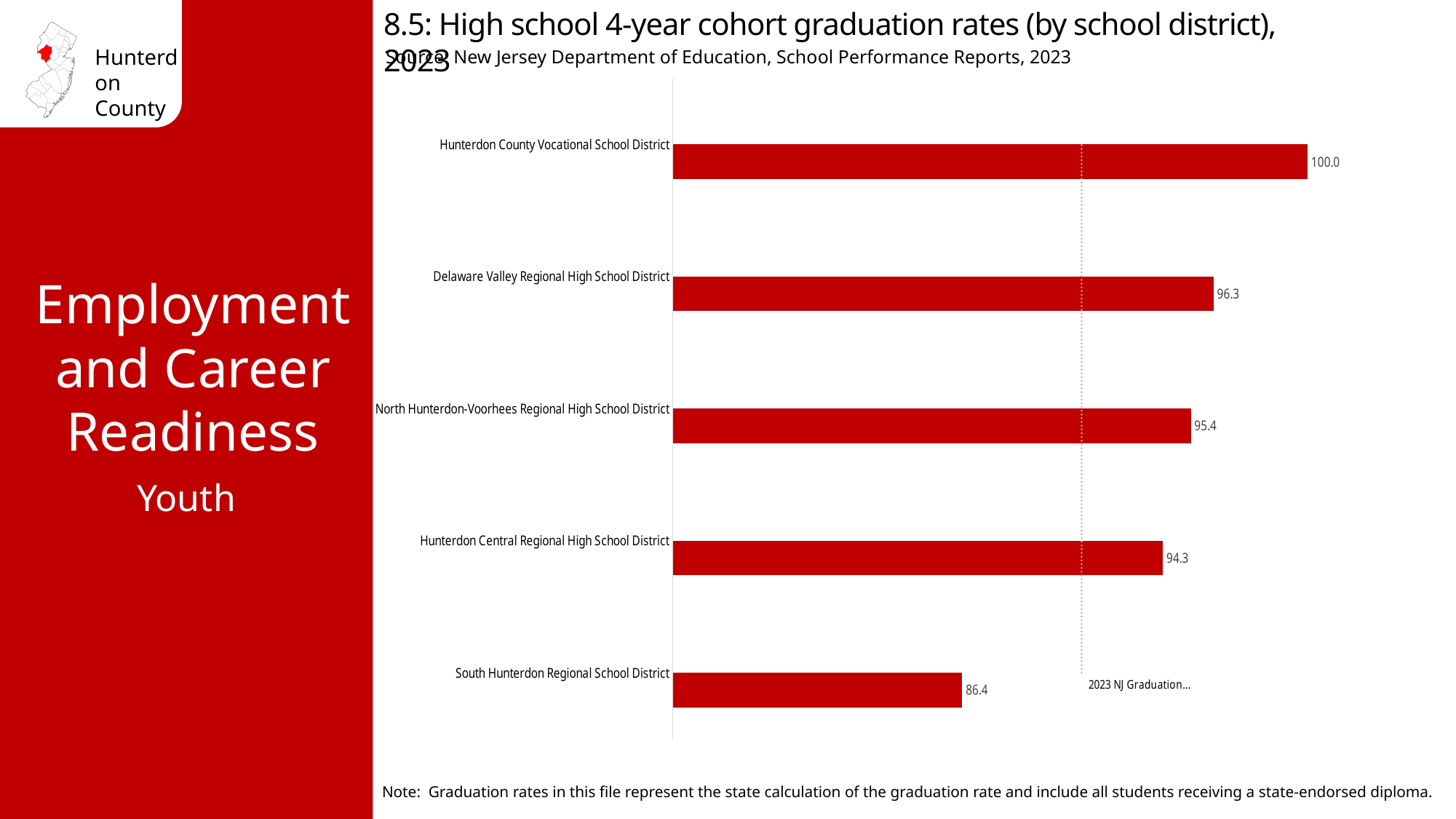
What is the source cited for the chart data? New Jersey Department of Education, School Performance Reports, 2023 What is the graduation rate for South Hunterdon Regional School District? 86.4 How many school districts are shown in the chart? 5 Which school district has the lowest graduation rate? South Hunterdon Regional School District What is the graduation rate for Hunterdon Central Regional High School District? 94.3 What is the graduation rate for Hunterdon County Vocational School District? 100.0 Which has a higher graduation rate, Delaware Valley Regional High School District or Hunterdon Central Regional High School District? Delaware Valley Regional High School District What is the difference between the graduation rates of Hunterdon County Vocational School District and Hunterdon Central Regional High School District? 5.7 What kind of chart is shown on the slide? Bar chart Which school district has the highest graduation rate? Hunterdon County Vocational School District What is the graduation rate for North Hunterdon-Voorhees Regional High School District? 95.4 What is the difference between the graduation rates of Delaware Valley Regional High School District and South Hunterdon Regional School District? 9.9